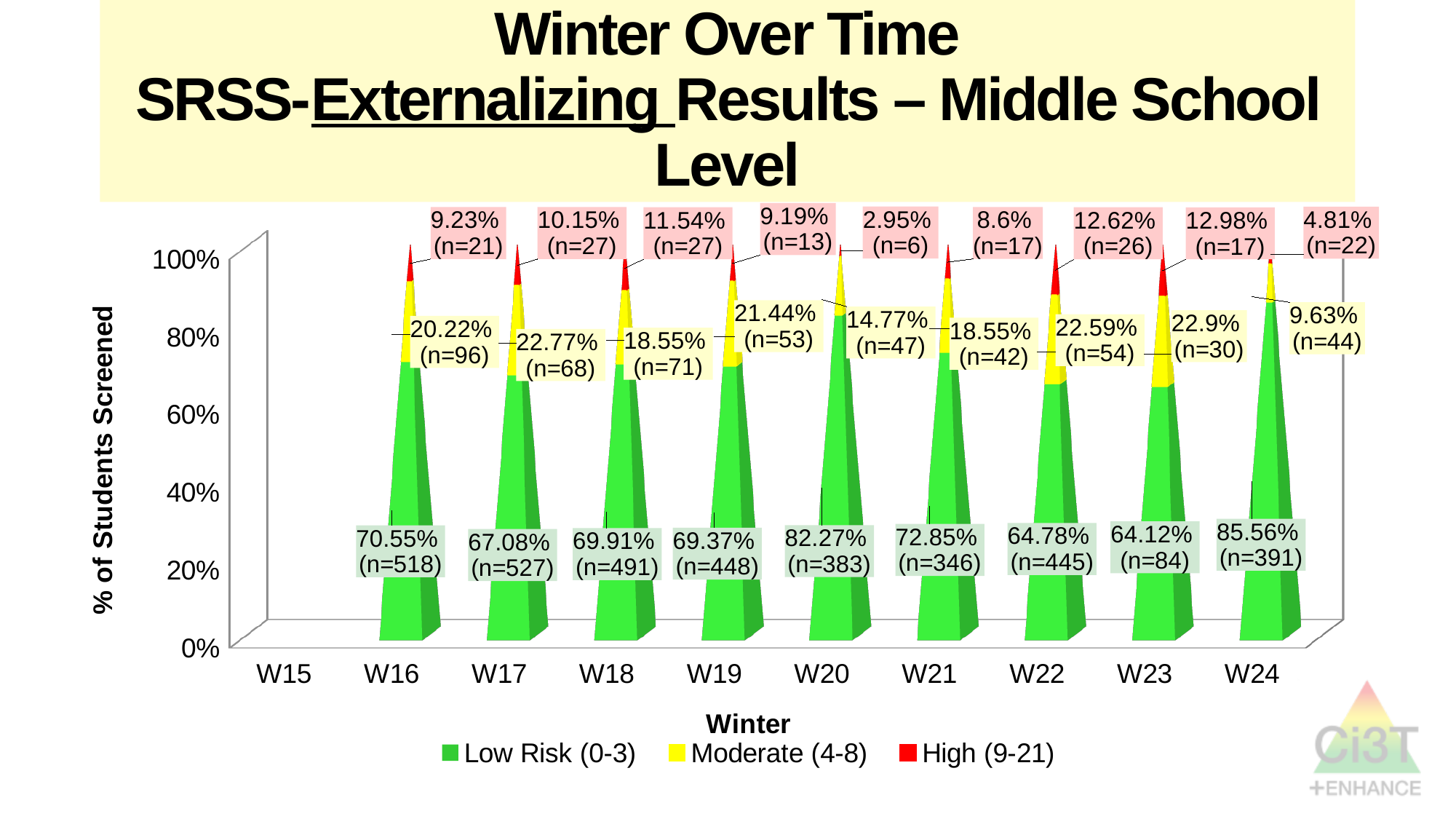
Which winter has the lowest High (9-21) percentage? W20 What is the Moderate (4-8) percentage for W19? 21.44% What is the difference between the Low Risk (0-3) percentages for W24 and W23? 21.44% Which is larger, the Moderate (4-8) percentage for W22 or for W24? W22 How many series does the legend list? 3 Which risk category is shown in red in the legend? High (9-21) What is the Low Risk (0-3) percentage for W20? 82.27% How many students were in the Low Risk (0-3) group in W17? n=527 What is the High (9-21) percentage for W23? 12.98% How many winters have data plotted in the chart? 9 What kind of chart is shown on the slide? Stacked bar chart Which winter has the highest Low Risk (0-3) percentage? W24